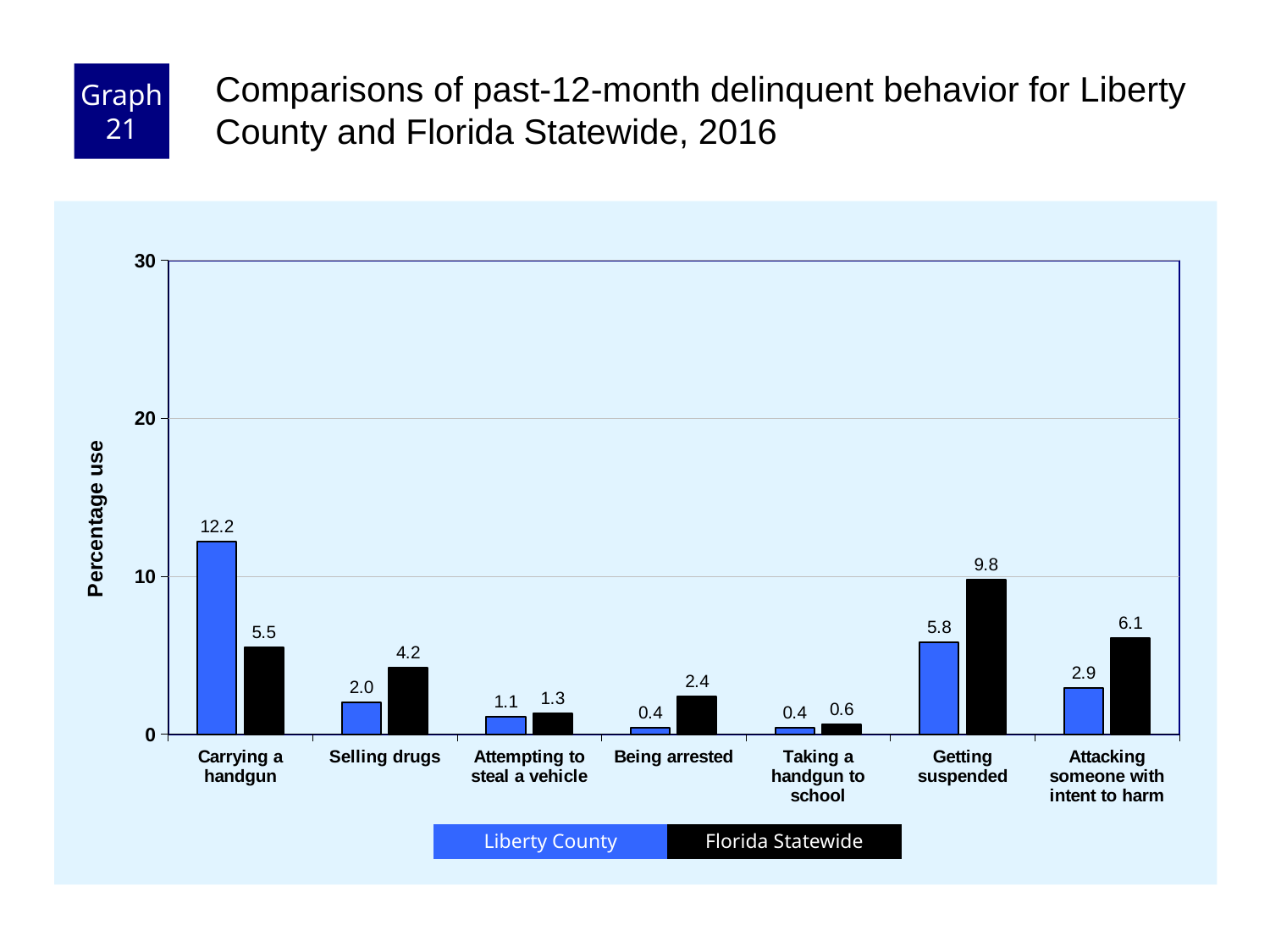
What kind of chart is shown on the slide? Bar chart Which category has the highest Liberty County value? Carrying a handgun How many categories are shown on the x axis? 7 What is the Florida Statewide value for Getting suspended? 9.8 Which category has the lowest Florida Statewide value? Taking a handgun to school What is the Florida Statewide value for Being arrested? 2.4 What is the difference between the Liberty County and Florida Statewide values for Carrying a handgun? 6.7 What is the difference between the Florida Statewide and Liberty County values for Getting suspended? 4.0 Which is larger for Attacking someone with intent to harm: Liberty County or Florida Statewide? Florida Statewide What is the Liberty County value for Carrying a handgun? 12.2 How many series does the legend list? 2 Is the Liberty County value for Carrying a handgun greater or less than 10? greater